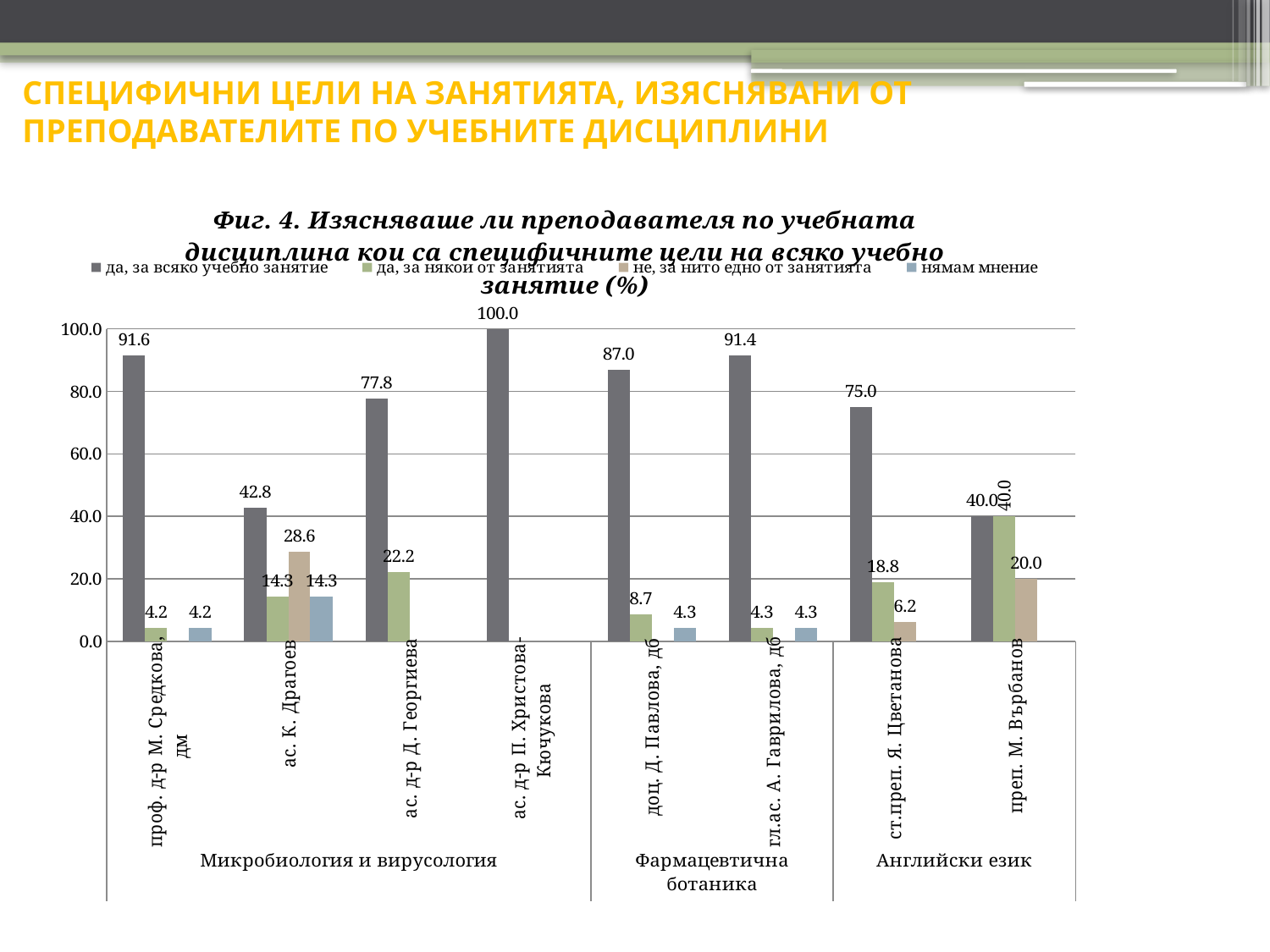
Is the "да, за всяко учебно занятие" value for ас. д-р Д. Георгиева greater or less than 60.0? greater What type of chart is shown on the slide? bar chart What is the value of "да, за някои от занятията" for ст.преп. Я. Цветанова? 18.8 How many instructors (categories) are shown on the x axis? 8 Which is larger: the "да, за всяко учебно занятие" value for доц. Д. Павлова, дб or for гл.ас. А. Гаврилова, дб? гл.ас. А. Гаврилова, дб How many series does the legend list? 4 Which instructor has the highest value for "да, за всяко учебно занятие"? ас. д-р П. Христова-Кючукова What is the value of "да, за всяко учебно занятие" for ас. д-р П. Христова-Кючукова? 100.0 Which instructor has the lowest value for "да, за всяко учебно занятие"? преп. М. Върбанов What is the value of "не, за нито едно от занятията" for ас. К. Драгоев? 28.6 Which discipline group contains the most instructors on the x axis? Микробиология и вирусология What is the difference between the "да, за всяко учебно занятие" values for проф. д-р М. Средкова, дм and ас. К. Драгоев? 48.8